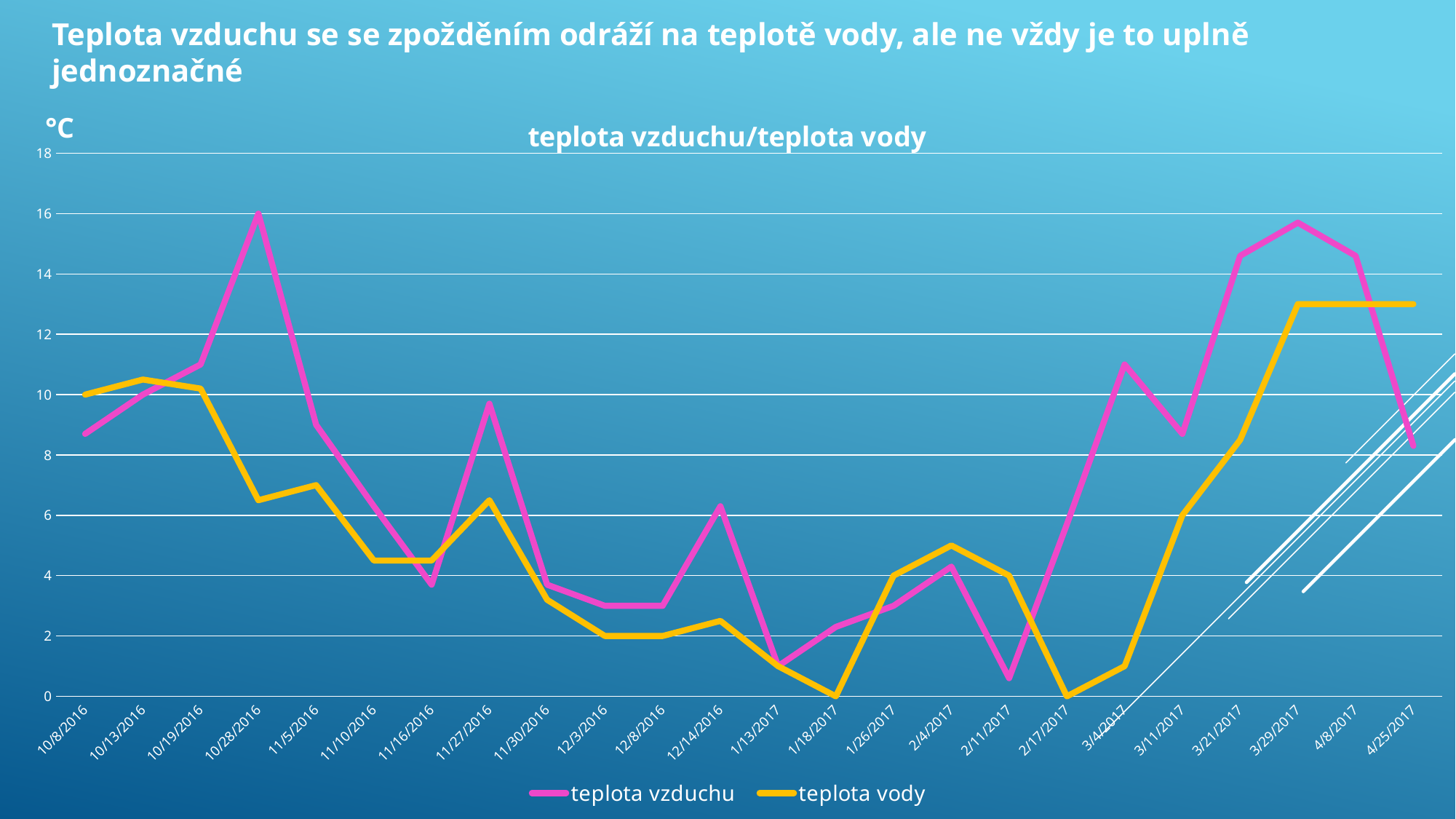
How many series does the legend list? 2 What is the value of teplota vody on 10/8/2016? 10 On 2/11/2017, which series has the higher value, teplota vzduchu or teplota vody? teplota vody Is the value of teplota vzduchu on 3/4/2017 greater or less than 10? greater What is the value of teplota vzduchu on 10/28/2016? 16 On 3/21/2017, which series has the higher value, teplota vzduchu or teplota vody? teplota vzduchu Does teplota vody rise or fall between 2/17/2017 and 4/8/2017? rise What kind of chart is shown on the slide? line chart What is the value of teplota vody on 1/18/2017? 0 What is the title of the chart? teplota vzduchu/teplota vody How many dates are shown on the x axis? 24 Is the value of teplota vody on 11/5/2016 greater or less than 8? less